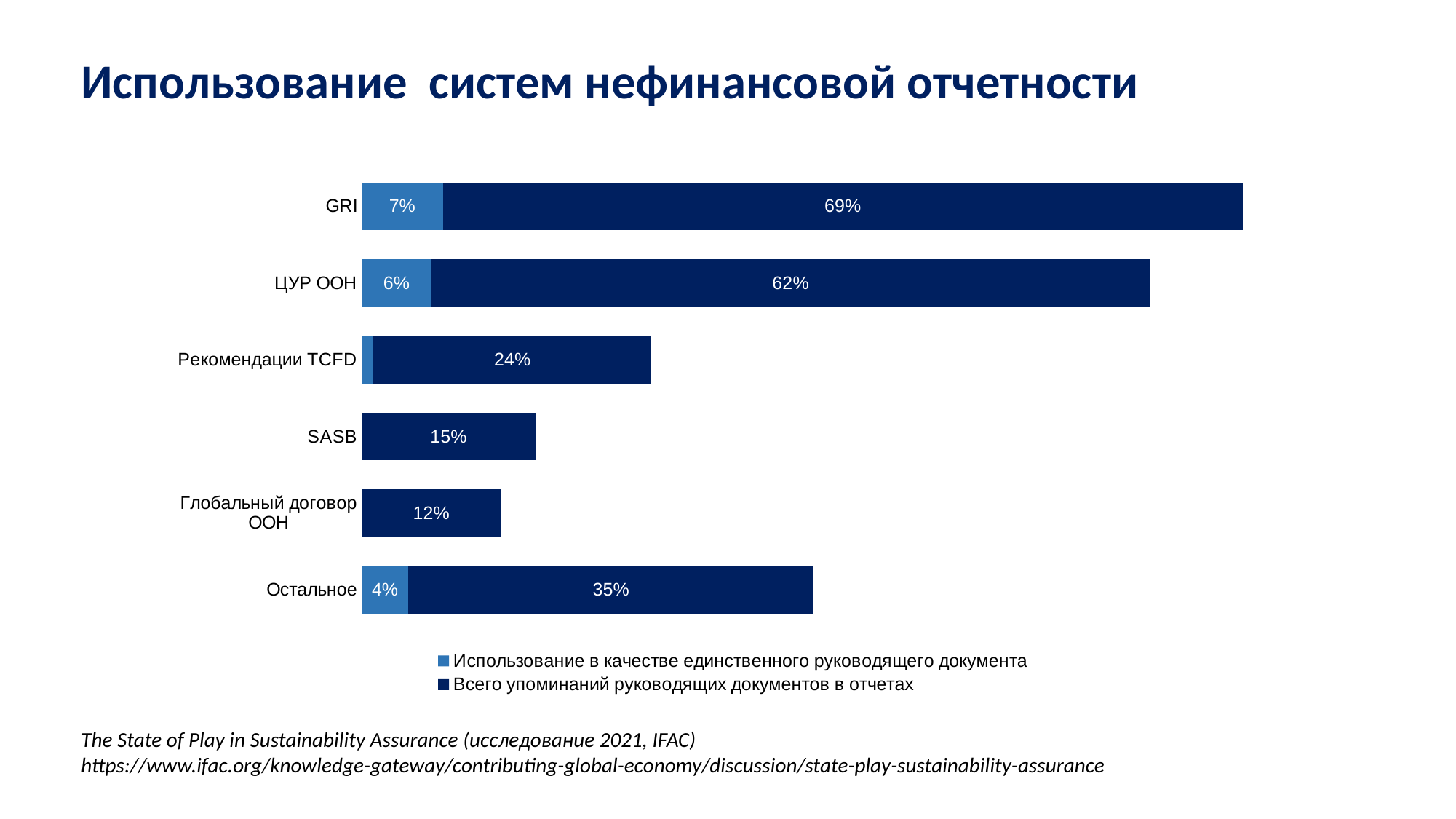
What is the total of the stacked bar for GRI? 76% Which category has the highest value for 'Всего упоминаний руководящих документов в отчетах'? GRI How many categories are shown on the chart? 6 Which category has the lowest value for 'Всего упоминаний руководящих документов в отчетах'? Глобальный договор ООН What kind of chart is shown on the slide? Stacked bar chart What is the value of 'Всего упоминаний руководящих документов в отчетах' for SASB? 15% How many series does the legend list? 2 What is the value of 'Использование в качестве единственного руководящего документа' for ЦУР ООН? 6% What is the difference between the 'Всего упоминаний руководящих документов в отчетах' values for Остальное and SASB? 20% What is the difference between the 'Всего упоминаний руководящих документов в отчетах' values for GRI and ЦУР ООН? 7% What is the value of 'Всего упоминаний руководящих документов в отчетах' for GRI? 69% Which has a larger value for 'Всего упоминаний руководящих документов в отчетах': Остальное or Рекомендации TCFD? Остальное